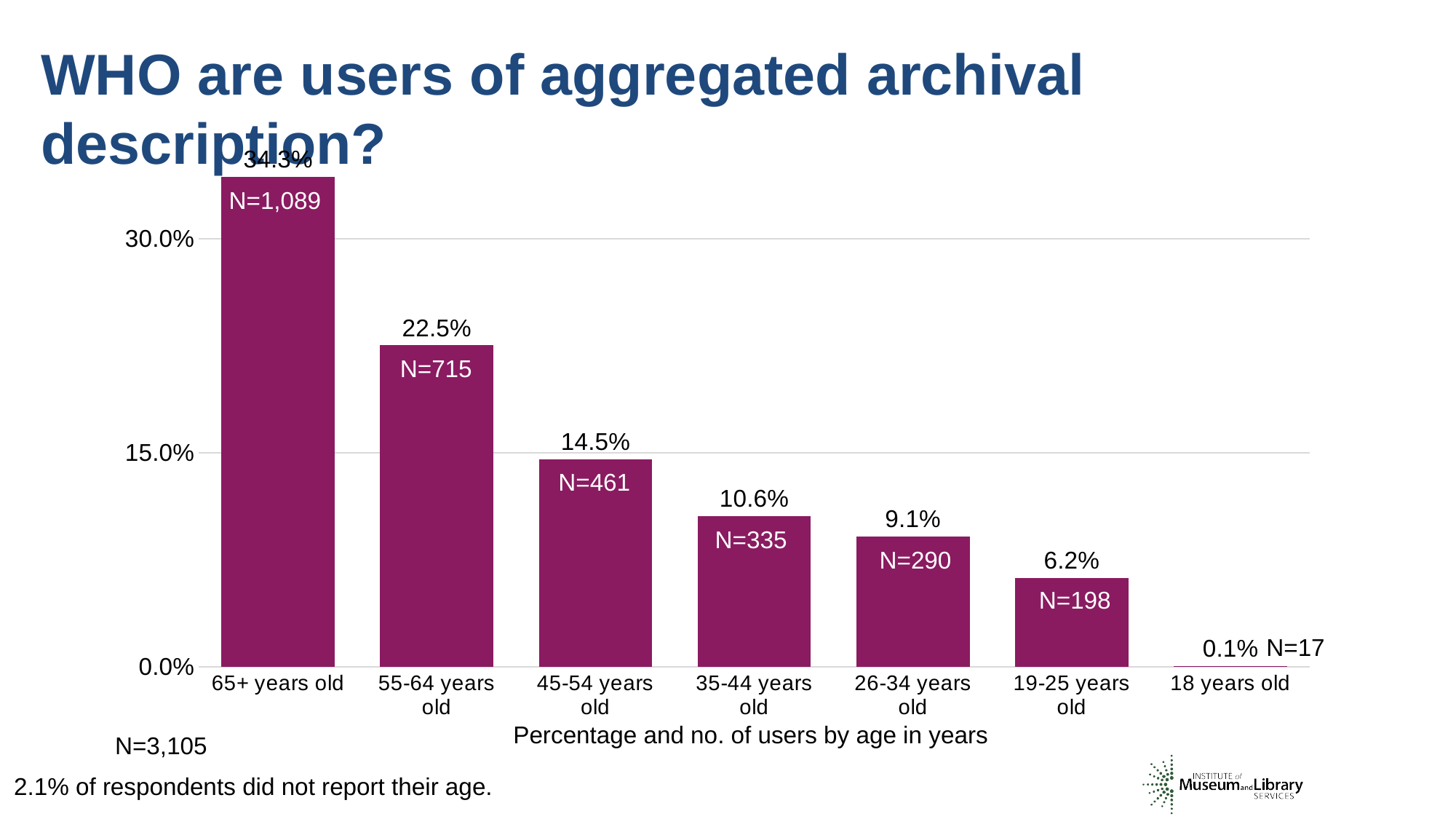
Which age group has the lowest percentage of users? 18 years old What is the N value shown for the 55-64 years old bar? N=715 Which group has a larger percentage of users: 26-34 years old or 19-25 years old? 26-34 years old What percentage of users are 65+ years old? 34.3% How many age groups are shown in the chart? 7 What is the total N reported below the chart? N=3,105 What kind of chart is shown on the slide? bar chart Do the percentages rise or fall moving from left to right along the x axis? fall Is the value for 45-54 years old greater or less than 15.0%? less Which age group has the highest percentage of users? 65+ years old What is the difference in percentage points between the 65+ years old and 55-64 years old groups? 11.8 What percentage of users are 35-44 years old? 10.6%